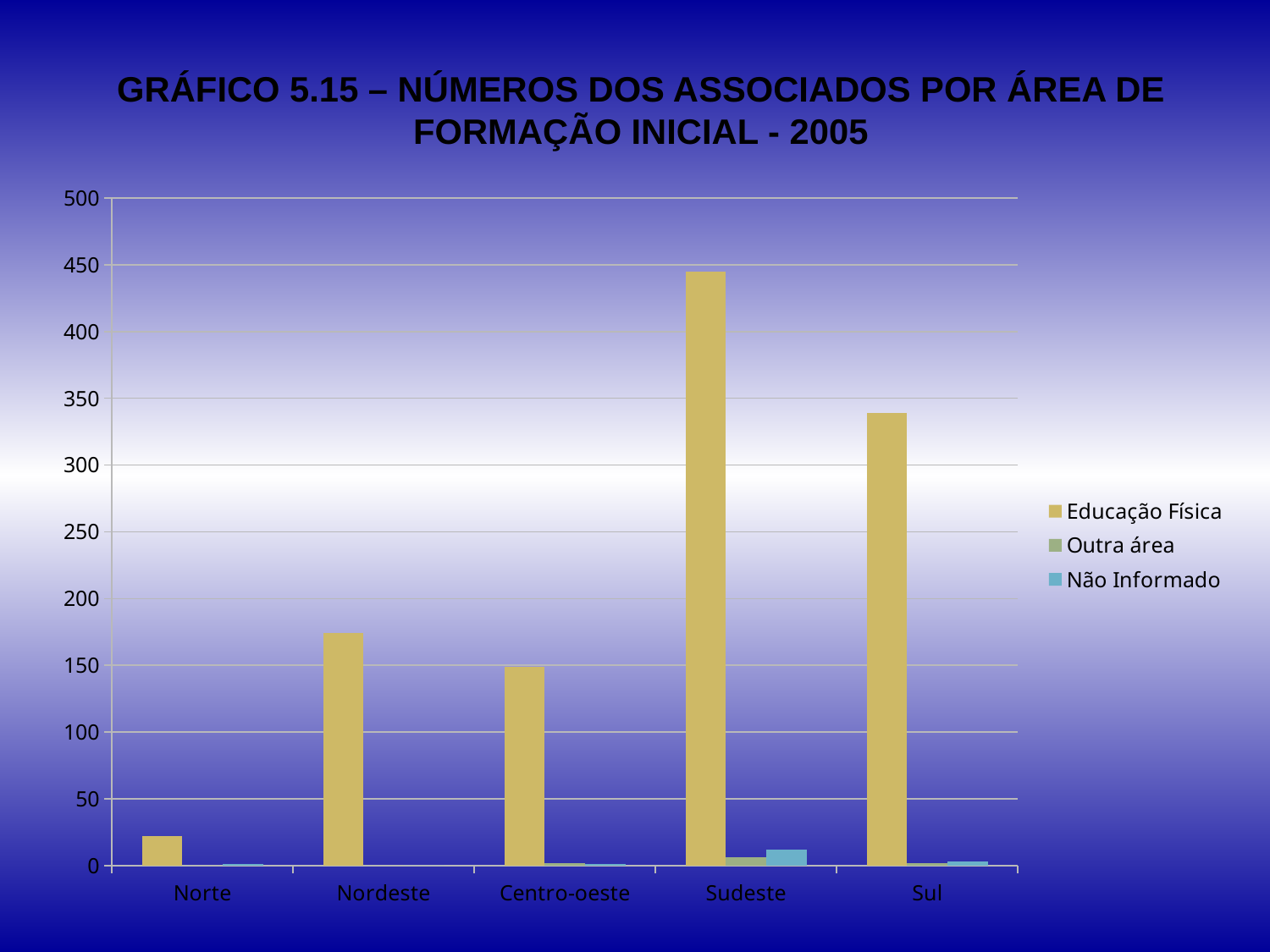
Which region has the larger Educação Física value, Sul or Sudeste? Sudeste How many regions (categories) are shown on the x axis? 5 Which series is shown in blue in the legend? Não Informado How many series does the legend list? 3 Which region has the larger Educação Física value, Nordeste or Centro-oeste? Nordeste What kind of chart is shown on the slide? Bar chart Which region has the lowest value for Educação Física? Norte Is the Educação Física value for Norte greater or less than 50? less Is the Educação Física value for Nordeste greater or less than 150? greater Is the Educação Física value for Sul greater or less than 300? greater Which region has the highest value for Educação Física? Sudeste